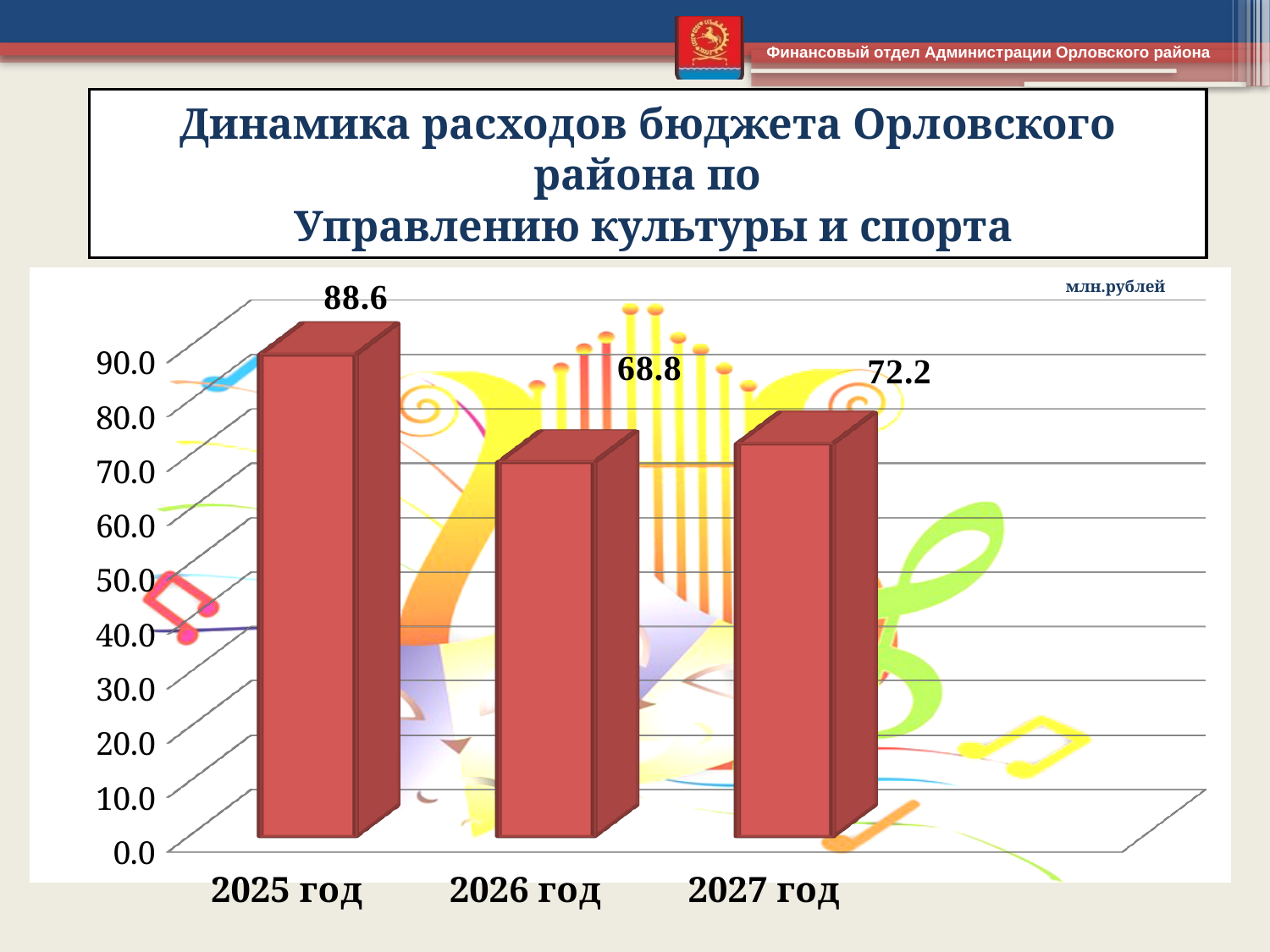
Which year has the highest value? 2025 год What is the difference between the values for 2027 год and 2026 год? 3.4 What kind of chart is shown on the slide? bar chart What unit is indicated in the top right corner of the chart? млн.рублей What is the value for 2026 год? 68.8 What is the difference between the values for 2025 год and 2026 год? 19.8 Which year has the lowest value? 2026 год Is the value for 2025 год greater or less than 80.0? greater How many years are shown on the chart? 3 What is the value for 2027 год? 72.2 What is the value for 2025 год? 88.6 Which is larger, the value for 2026 год or 2027 год? 2027 год